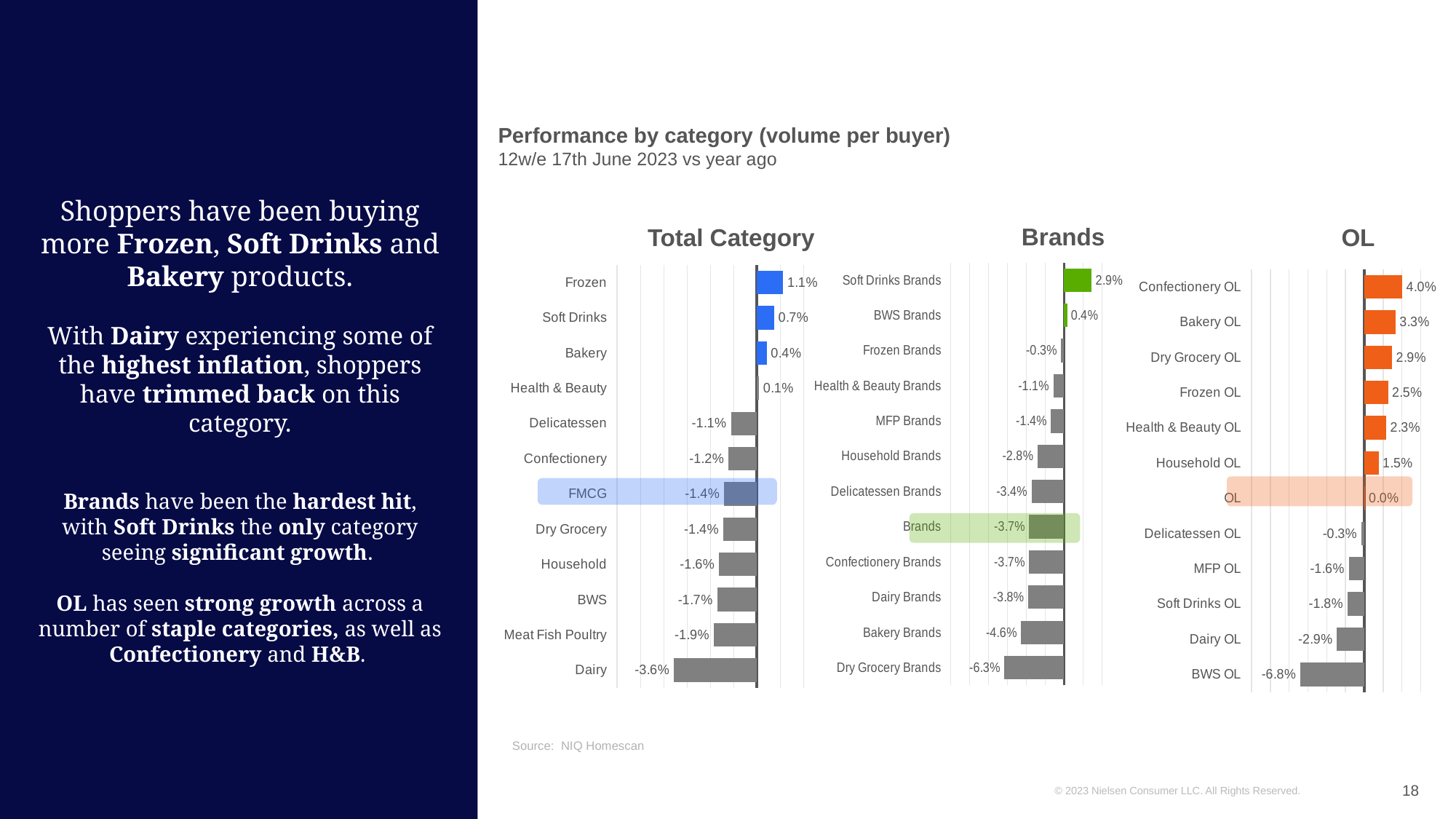
What kind of chart is the Total Category chart? Bar chart In the Total Category chart, which category has the lowest value? Dairy What is the title of the chart section on the slide? Performance by category (volume per buyer) In the Brands chart, which category has the highest value? Soft Drinks Brands In the OL chart, what is the value for Confectionery OL? 4.0% In the Total Category chart, what is the difference between the values for Frozen and Dairy? 4.7 percentage points In the OL chart, what is the difference between the values for Confectionery OL and Household OL? 2.5 percentage points In the Total Category chart, what is the value for Frozen? 1.1% In the Brands chart, how many categories are plotted? 12 In the OL chart, which category has the lowest value? BWS OL In the OL chart, which is larger, the value for Bakery OL or the value for Frozen OL? Bakery OL In the Brands chart, what is the value for Dry Grocery Brands? -6.3%